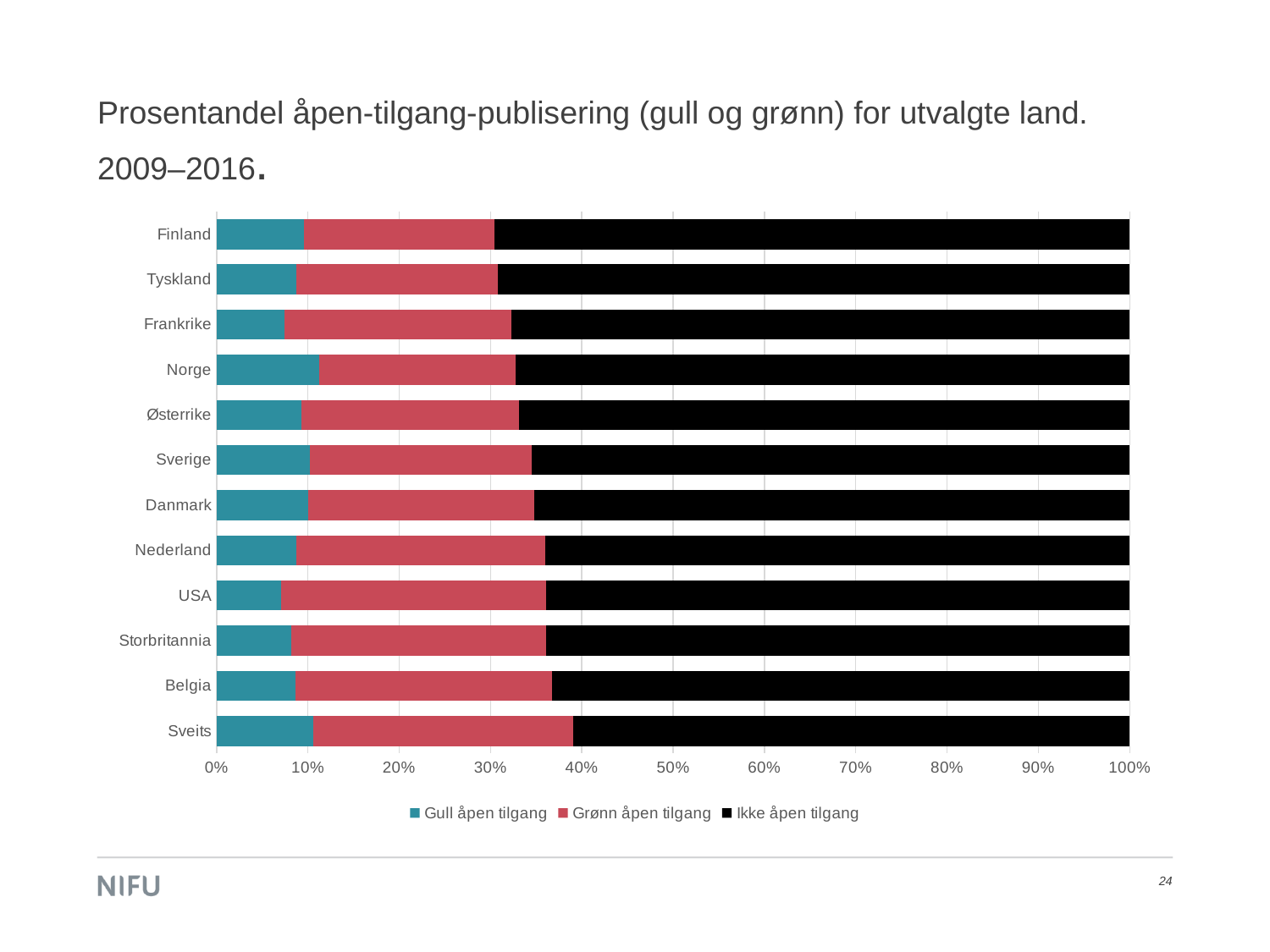
Is the combined open access share (Gull plus Grønn) for Belgia greater or less than 30%? greater How many series does the legend list? 3 Is the Gull åpen tilgang share for USA greater or less than 10%? less Which country has the smallest share of Ikke åpen tilgang? Sveits Which country has the largest combined share of open access (Gull plus Grønn)? Sveits How many countries are shown on the chart? 12 Which country is listed at the top of the chart? Finland Is the Ikke åpen tilgang share for Finland greater or less than 60%? greater What kind of chart is shown on the slide? Stacked bar chart Going down the chart from Finland to Sveits, does the share of Ikke åpen tilgang increase or decrease? decrease Which has a larger combined open access share (Gull plus Grønn): Sveits or Finland? Sveits What are the three series named in the legend? Gull åpen tilgang, Grønn åpen tilgang, Ikke åpen tilgang